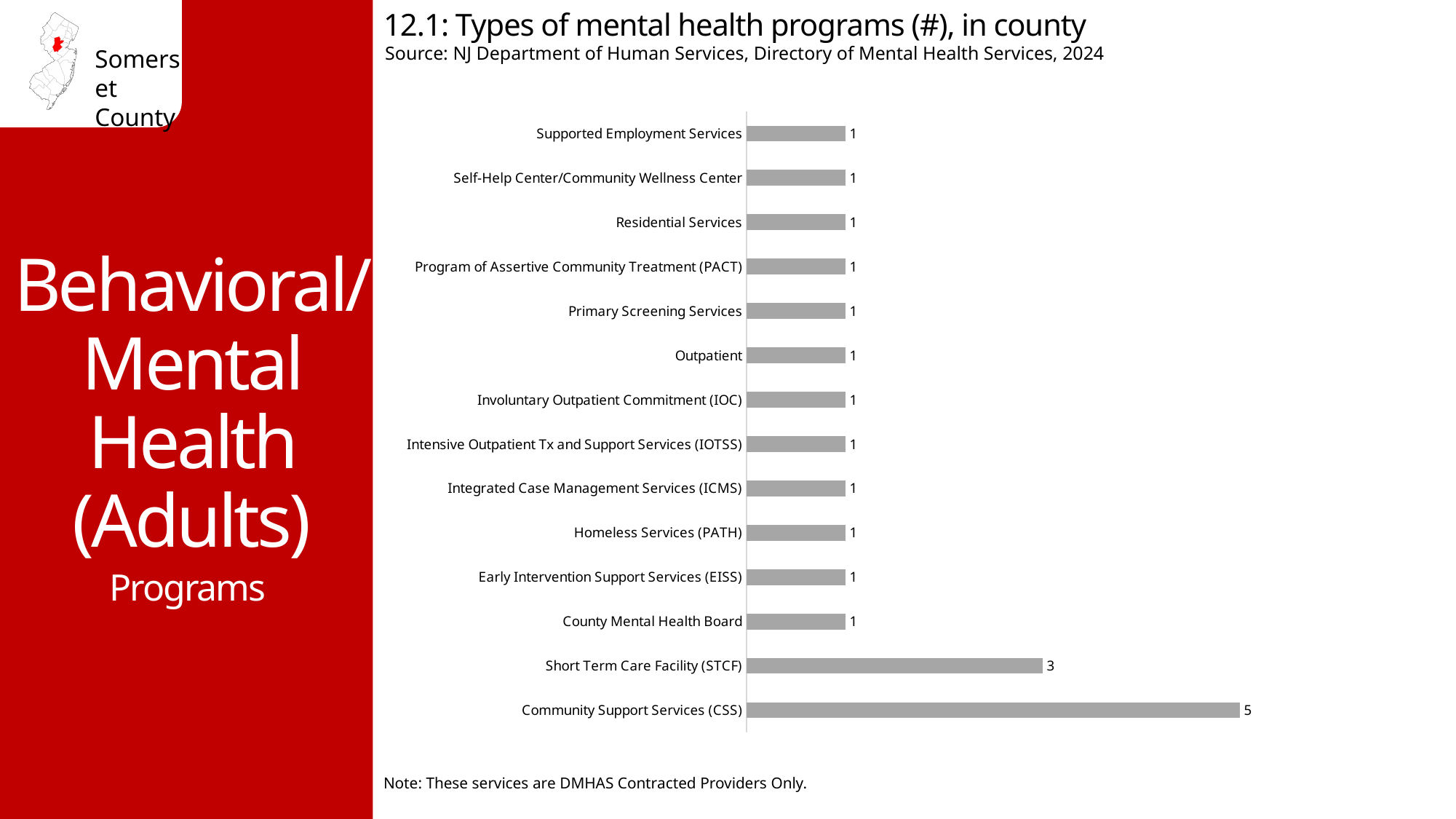
What is the value for Homeless Services (PATH)? 1 What is the value for Short Term Care Facility (STCF)? 3 How many types of mental health programs are listed in the chart? 14 What is the difference between the values for Community Support Services (CSS) and Short Term Care Facility (STCF)? 2 Which is larger, the value for Short Term Care Facility (STCF) or the value for Outpatient? Short Term Care Facility (STCF) How many programs are shown for Community Support Services (CSS)? 5 What kind of chart is shown on the slide? Bar chart What is the difference between the values for Short Term Care Facility (STCF) and County Mental Health Board? 2 Which type of mental health program has the highest number? Community Support Services (CSS) What is the value for Program of Assertive Community Treatment (PACT)? 1 What is the title of the chart? 12.1: Types of mental health programs (#), in county What is the source cited for the chart? NJ Department of Human Services, Directory of Mental Health Services, 2024